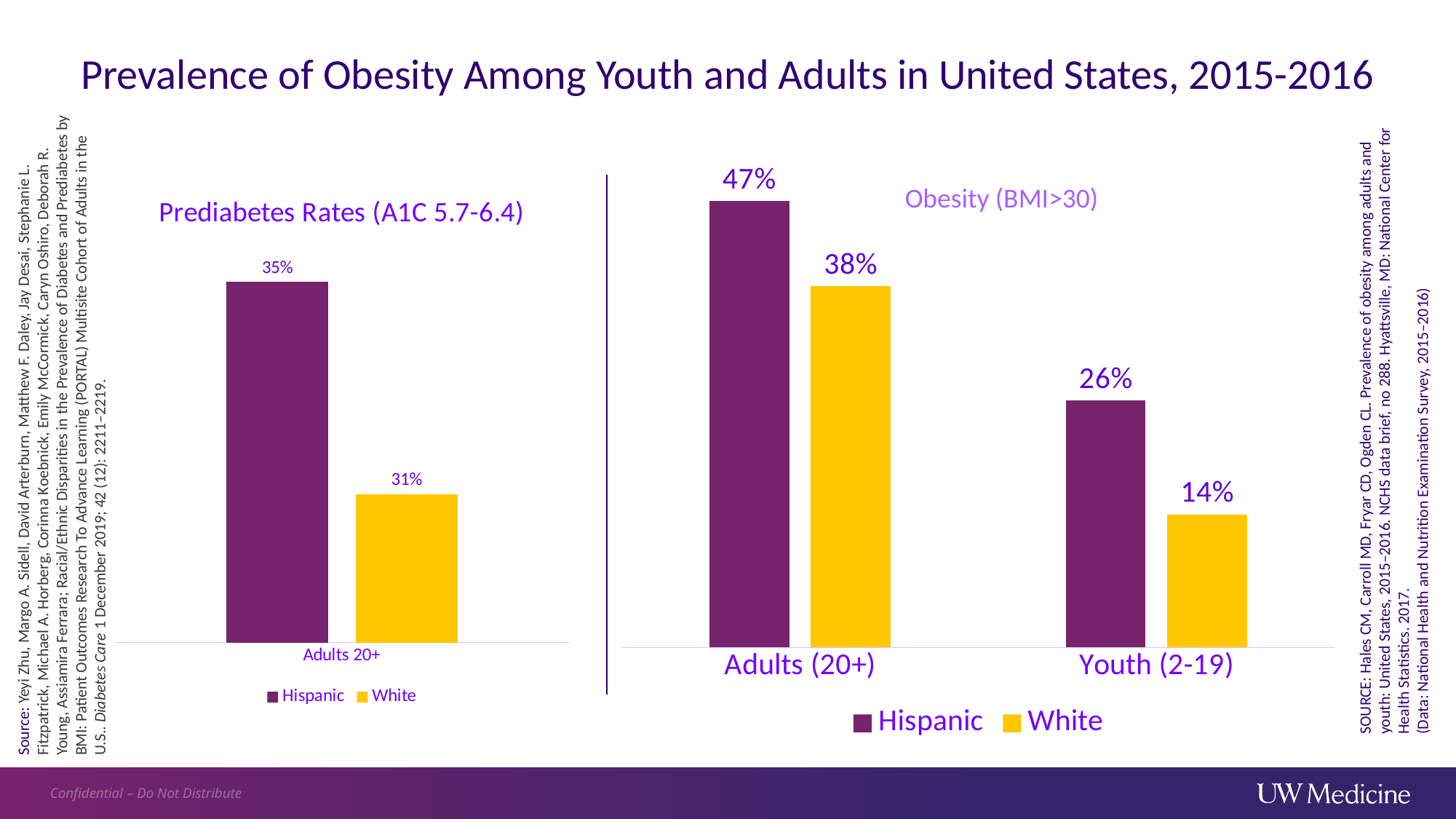
In the Obesity (BMI>30) chart, which bar has the lowest value? White Youth (2-19) In the Prediabetes Rates (A1C 5.7-6.4) chart, what is the difference between the Hispanic and White values? 4% In the Prediabetes Rates (A1C 5.7-6.4) chart, what is the value for Hispanic adults 20+? 35% In the Obesity (BMI>30) chart, what is the value for Hispanic Youth (2-19)? 26% In the Obesity (BMI>30) chart, which is larger: the Hispanic value for Youth (2-19) or the White value for Adults (20+)? White Adults (20+) In the Obesity (BMI>30) chart, what is the value for Hispanic Adults (20+)? 47% How many categories are shown on the x axis of the Obesity (BMI>30) chart? 2 In the Obesity (BMI>30) chart, what is the value for White Youth (2-19)? 14% How many series does the legend of the Obesity (BMI>30) chart list? 2 What kind of chart is the Prediabetes Rates (A1C 5.7-6.4) chart? Bar chart In the Obesity (BMI>30) chart, what is the difference between the Hispanic and White values for Adults (20+)? 9% In the Prediabetes Rates (A1C 5.7-6.4) chart, what is the value for White adults 20+? 31%